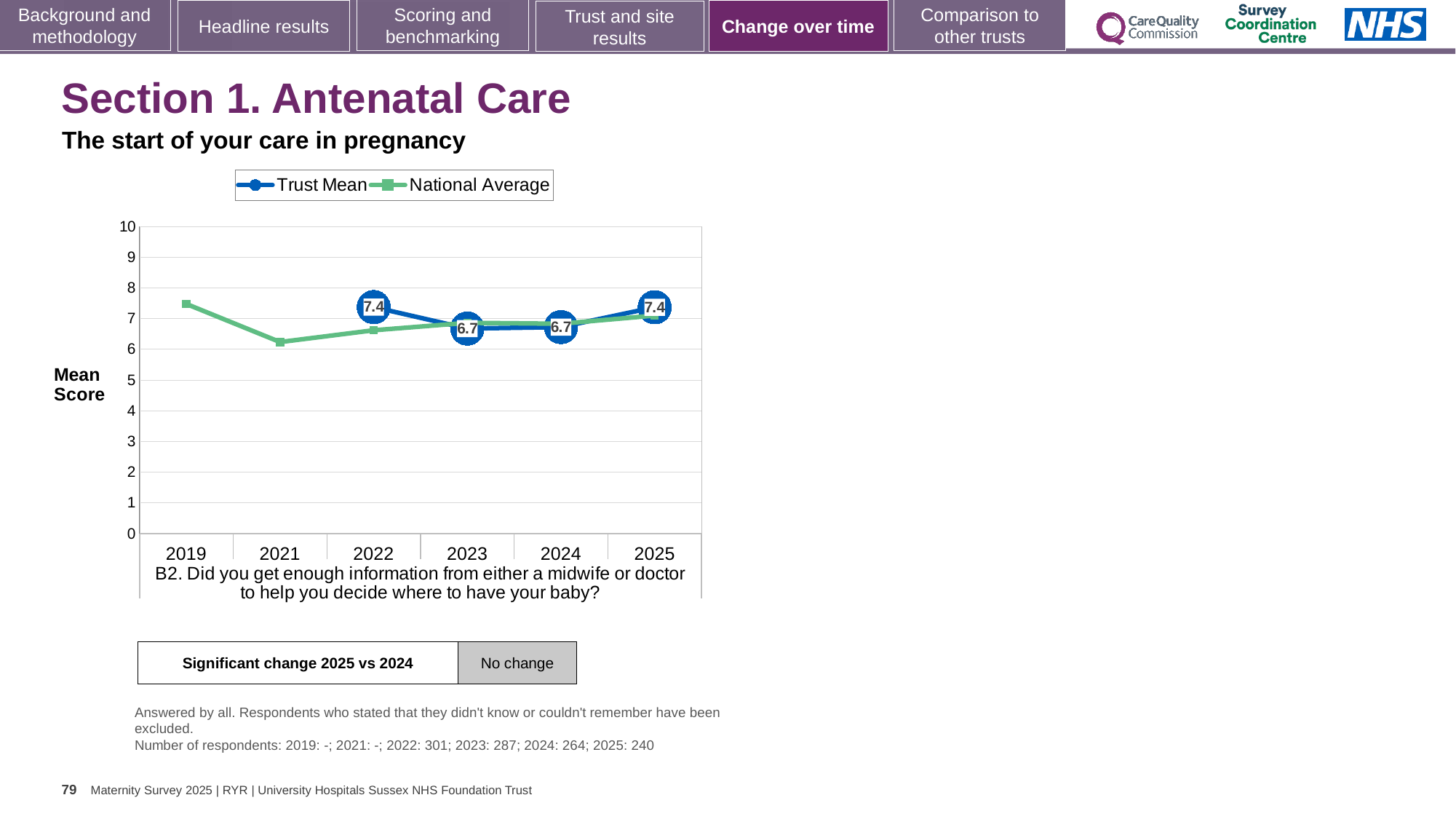
How many years are shown on the x axis? 6 How many series does the legend list? 2 What is the difference between the Trust Mean values for 2022 and 2023? 0.7 Does the Trust Mean rise or fall from 2024 to 2025? Rise What is the Trust Mean value for 2022? 7.4 Is the National Average value for 2021 greater or less than 7? less Which year has the higher Trust Mean value, 2022 or 2024? 2022 In which year is the National Average at its lowest? 2021 What is the Trust Mean value for 2025? 7.4 What kind of chart is shown on the slide? Line chart What is the Trust Mean value for 2023? 6.7 Is the National Average value for 2019 greater or less than 7? greater